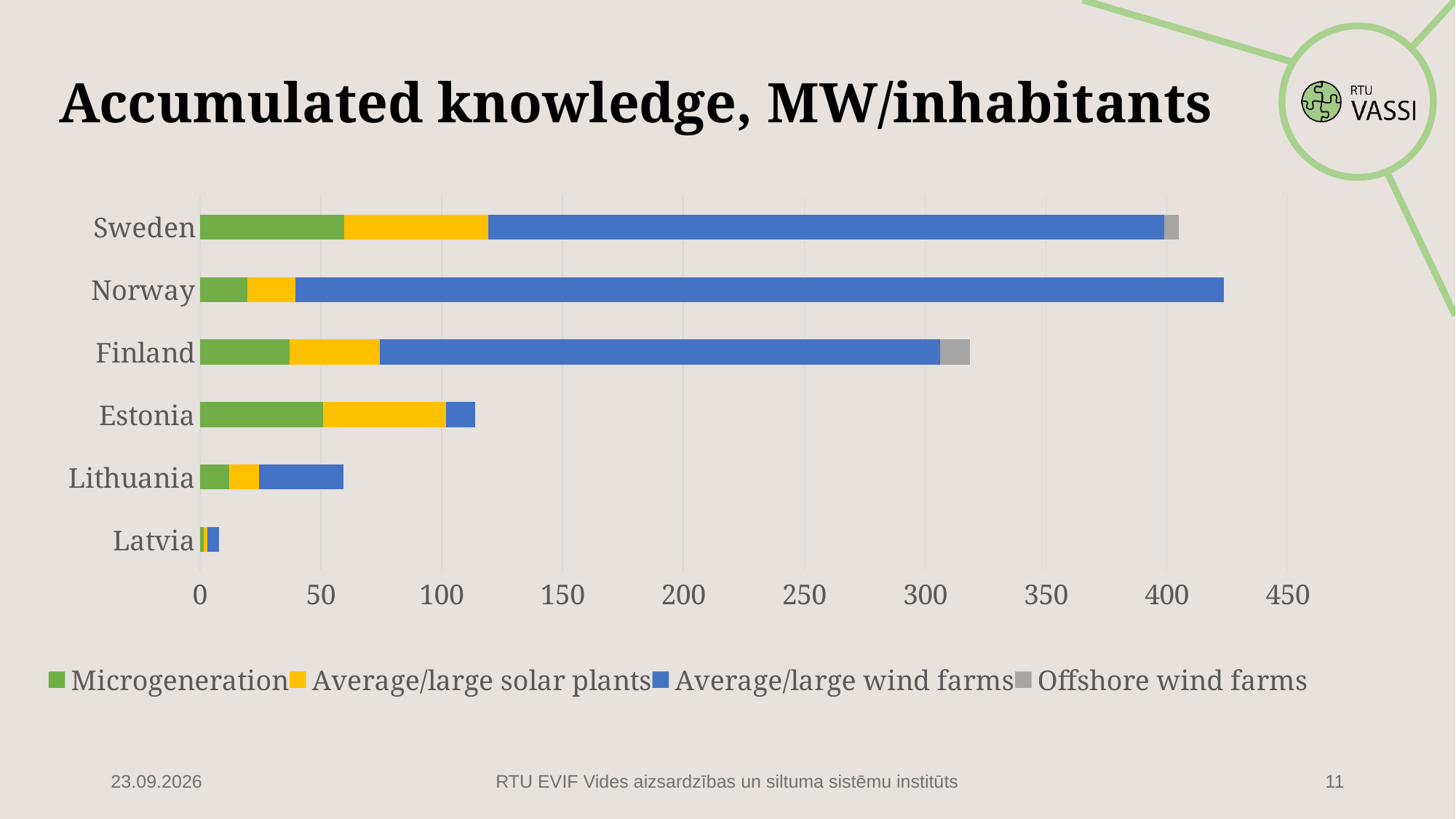
Is the total value for Norway greater or less than 400? greater Is the total value for Lithuania greater or less than 100? less Which country has the highest total bar? Norway Which has the larger total bar, Finland or Estonia? Finland How many countries are shown on the chart? 6 Which colour represents Average/large wind farms in the legend? blue What is the title of the chart? Accumulated knowledge, MW/inhabitants Which country has the lowest total bar? Latvia How many series does the legend list? 4 Is the total value for Finland greater or less than 300? greater What kind of chart is shown on the slide? stacked bar chart